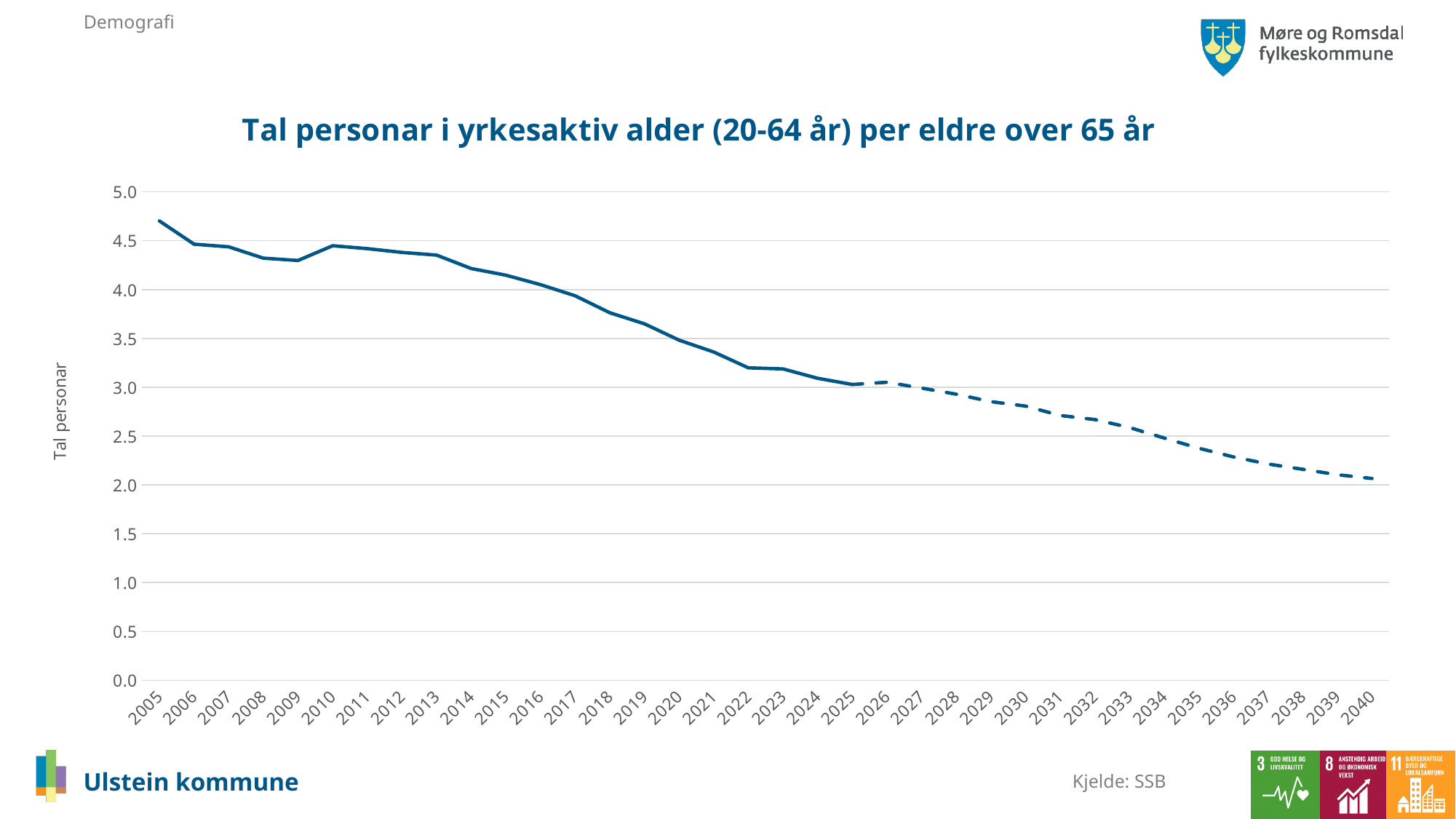
How many years are plotted on the x axis? 36 Is the value for 2030 greater or less than 3.0? less Which year has the highest value? 2005 Is the value for 2040 greater or less than 2.5? less Is the value for 2005 greater or less than 4.5? greater Which year has the lowest value? 2040 Which year has the larger value, 2010 or 2020? 2010 Do the values rise or fall along the x axis from 2005 to 2040? fall What is the title of the chart? Tal personar i yrkesaktiv alder (20-64 år) per eldre over 65 år What kind of chart is shown on the slide? line chart